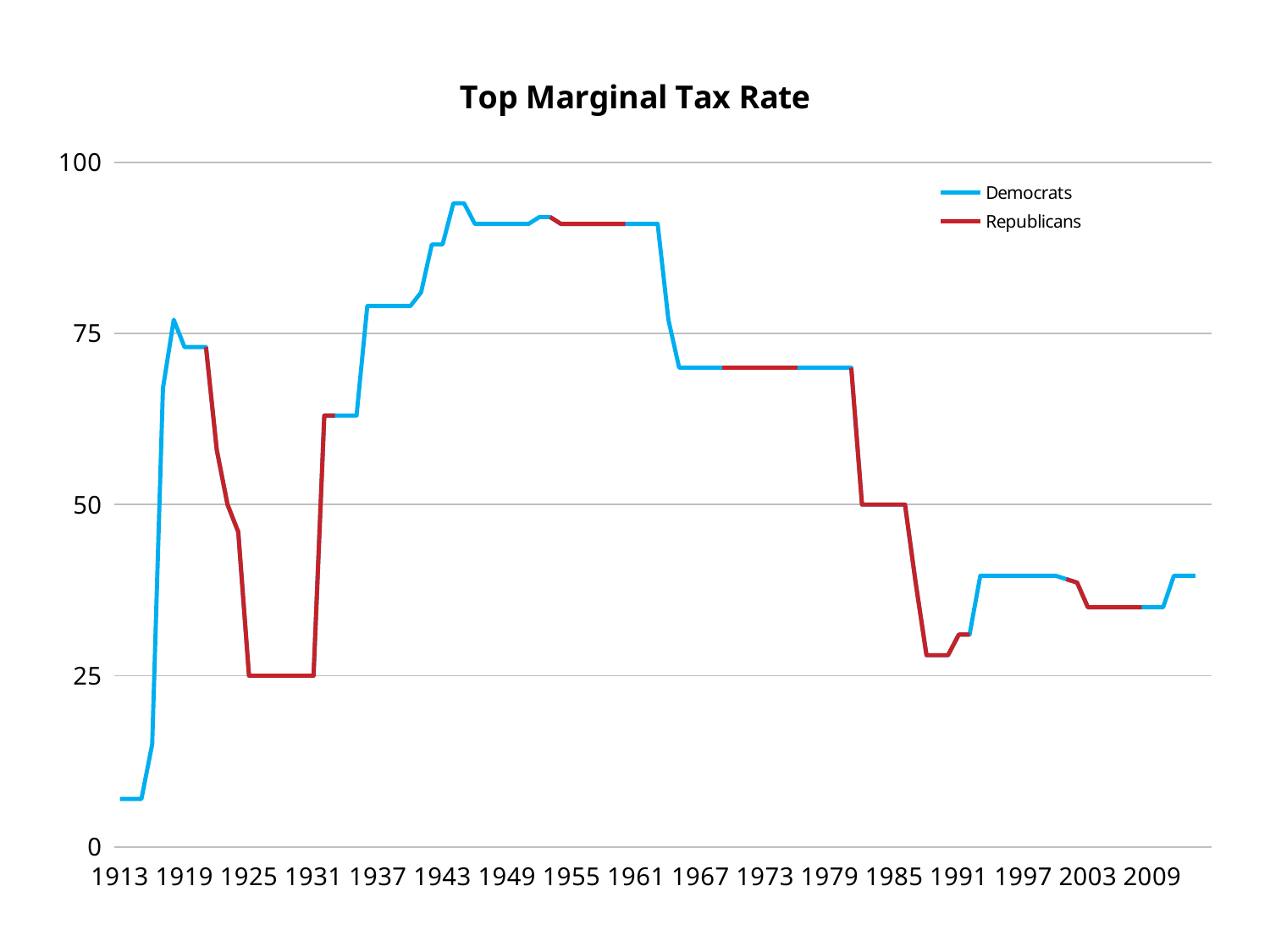
What value does the line sit at between 1925 and 1931? 25 Do the values rise or fall between 1961 and 1991? fall Is the value in 1913 greater or less than 25? less Is the value in 1955 greater or less than 75? greater Which series is drawn in red? Republicans Which is larger, the value in 1945 or the value in 1985? 1945 Is the value in 1945 greater or less than 75? greater What is the title of the chart? Top Marginal Tax Rate What kind of chart is shown on the slide? line chart How many series does the legend list? 2